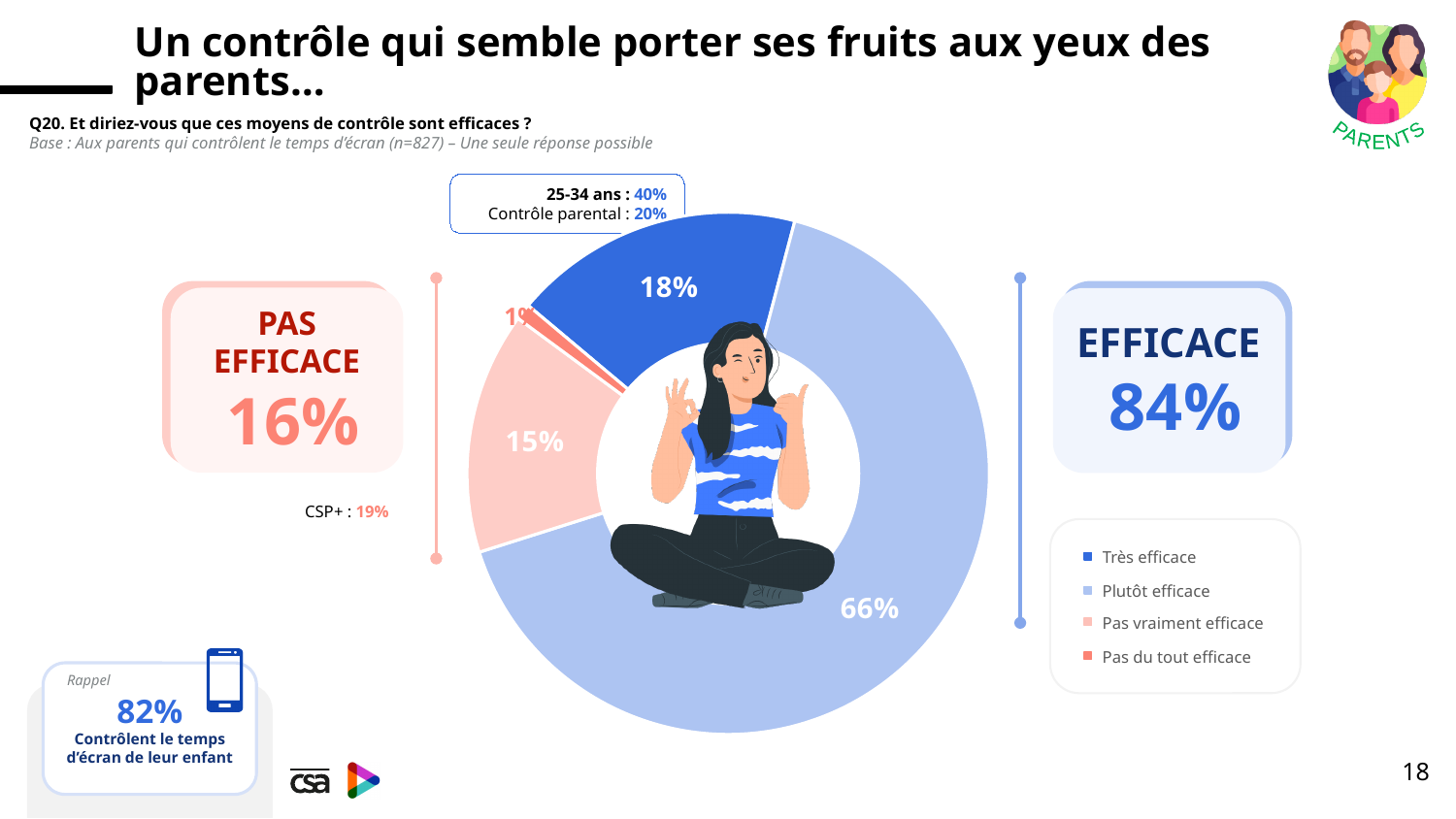
What is the combined share of "Très efficace" and "Plutôt efficace" (shown as EFFICACE)? 84% Which response category has the largest share of the pie? Plutôt efficace Which is larger: the share for "Très efficace" or the share for "Pas vraiment efficace"? Très efficace Which response category has the smallest share of the pie? Pas du tout efficace What is the difference in percentage points between "Plutôt efficace" and "Très efficace"? 48 What is the combined share of "Pas vraiment efficace" and "Pas du tout efficace" (shown as PAS EFFICACE)? 16% What percentage of parents answered "Plutôt efficace"? 66% What kind of chart is shown on the slide? Pie chart (donut) What is the sample size (n) given in the base of the chart? 827 What percentage of parents answered "Très efficace"? 18% What percentage of parents answered "Pas vraiment efficace"? 15% How many response categories does the legend list? 4